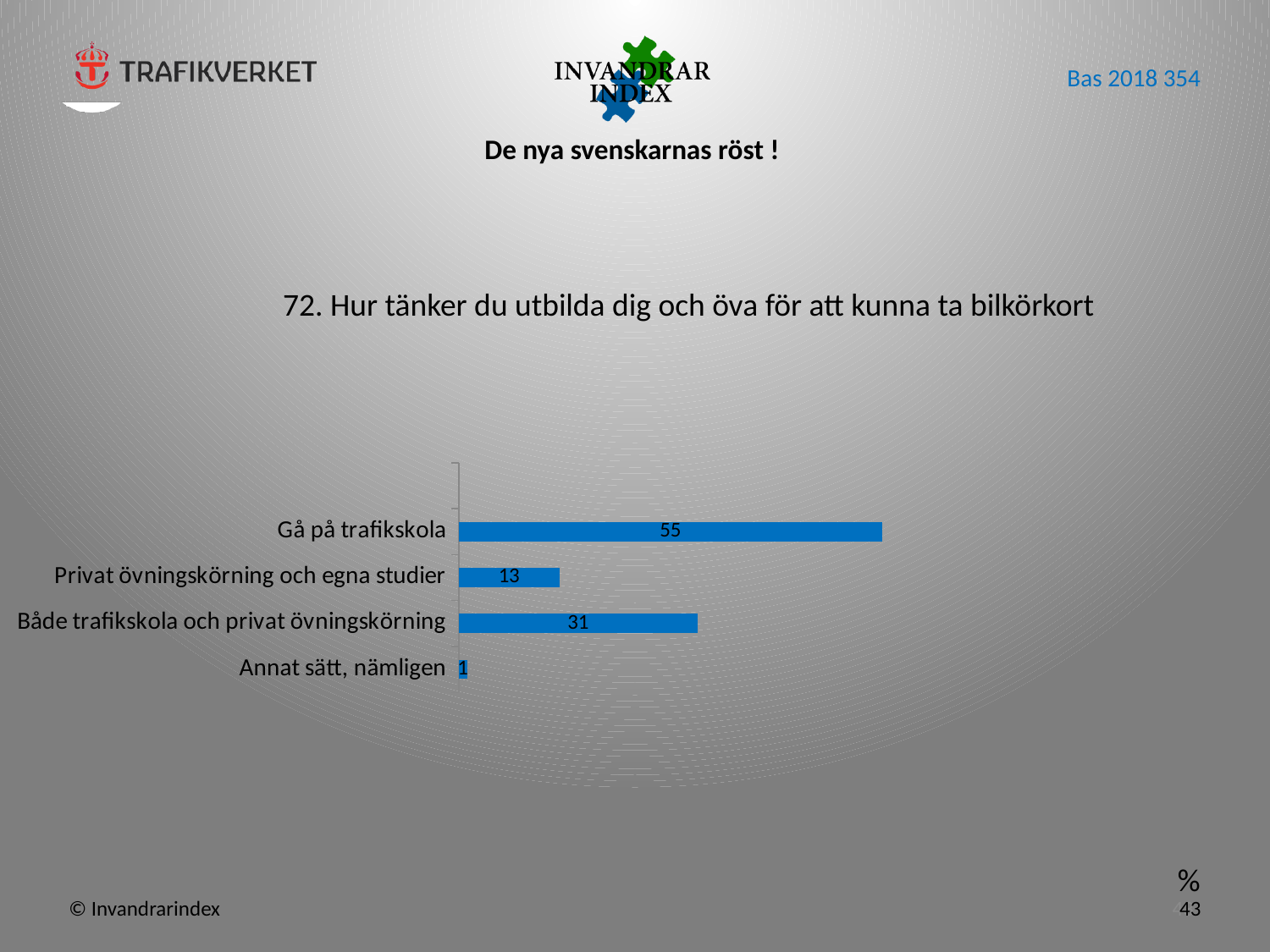
How many categories are shown in the chart? 4 What kind of chart is shown on the slide? Bar chart What is the value for "Annat sätt, nämligen"? 1 What is the title of the chart? 72. Hur tänker du utbilda dig och öva för att kunna ta bilkörkort Which category has the highest value? Gå på trafikskola Which category has the lowest value? Annat sätt, nämligen What is the difference between the values for "Gå på trafikskola" and "Både trafikskola och privat övningskörning"? 24 What is the value for "Privat övningskörning och egna studier"? 13 Which is larger, the value for "Privat övningskörning och egna studier" or for "Både trafikskola och privat övningskörning"? Både trafikskola och privat övningskörning What is the difference between the values for "Både trafikskola och privat övningskörning" and "Privat övningskörning och egna studier"? 18 What is the value for "Både trafikskola och privat övningskörning"? 31 What is the value for "Gå på trafikskola"? 55